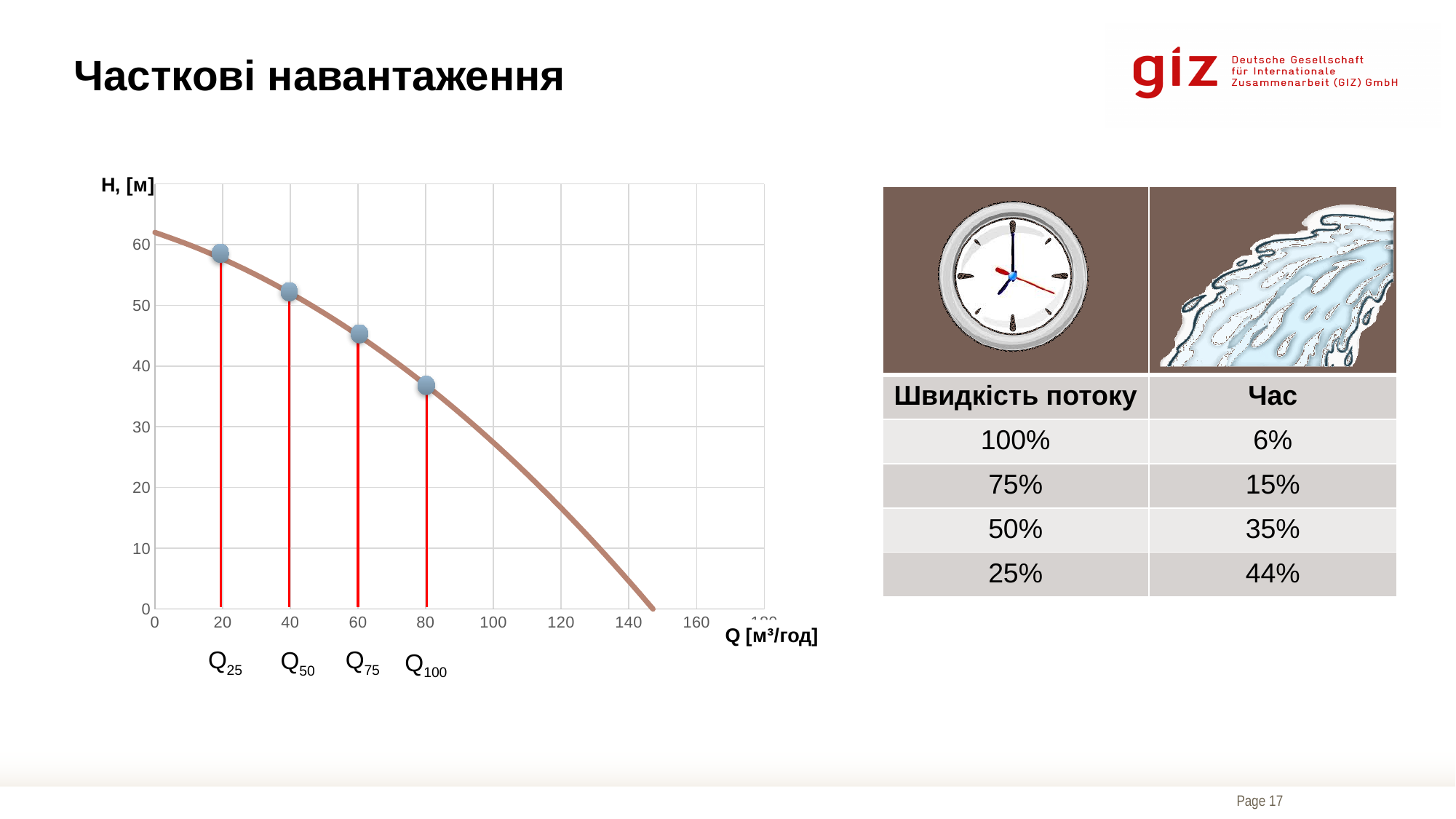
Which of the marked points has the lowest H value? Q100 What is the label of the vertical axis of the chart? H, [м] Is the H value at the Q100 point greater or less than 40? less Which of the marked points has the highest H value? Q25 At which Q value on the x axis is the Q50 point marked? 40 At which Q value on the x axis is the Q100 point marked? 80 Is the H value at the Q25 point greater or less than 50? greater Does the curve H rise or fall as Q increases along the x axis? fall At which Q value on the x axis is the Q25 point marked? 20 Which marked point has a larger H value, Q50 or Q75? Q50 How many marked points (Q25, Q50, Q75, Q100) are highlighted on the curve? 4 What kind of chart is shown on the slide? line chart